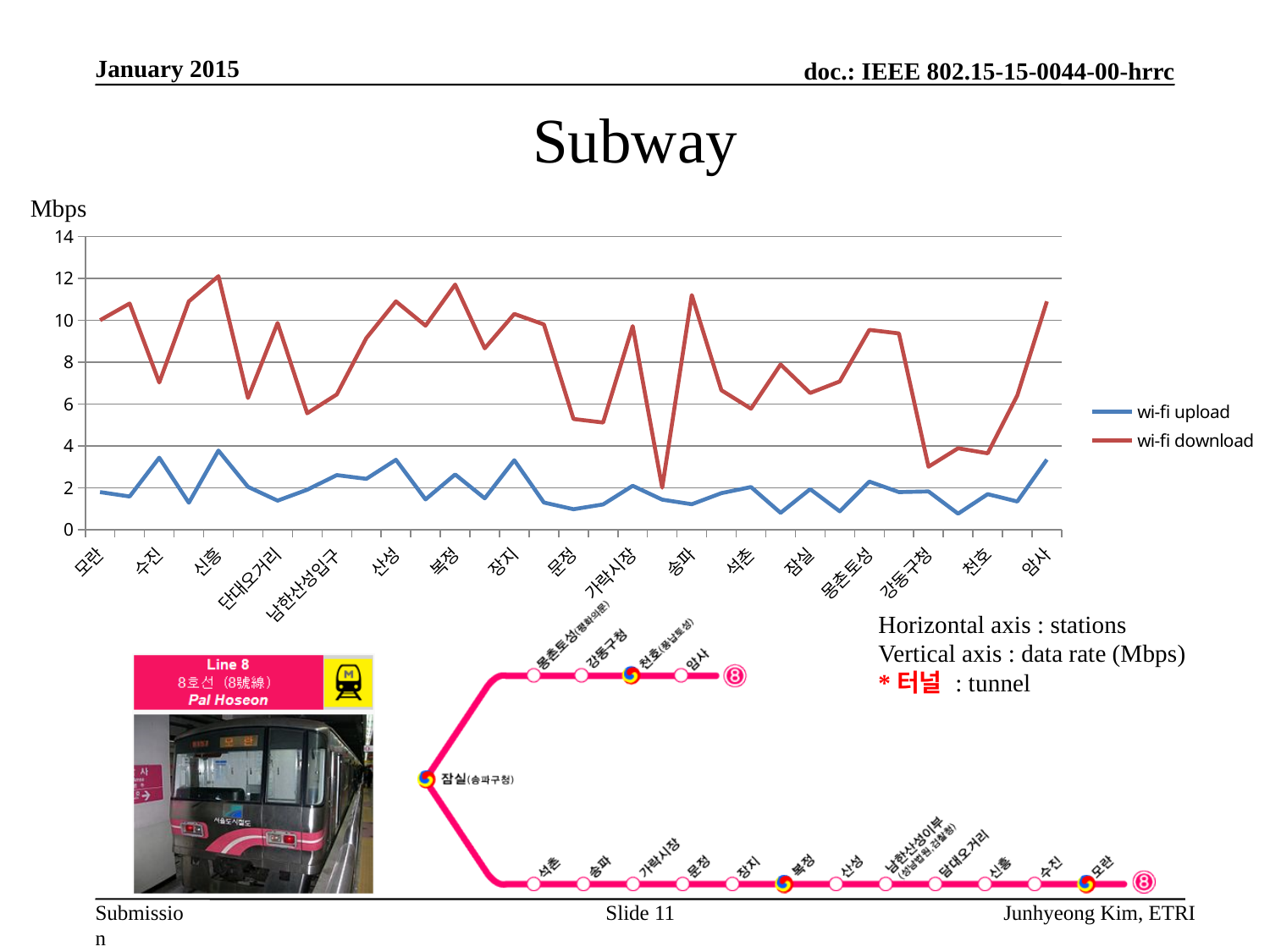
How many series does the chart legend list? 2 Is the wi-fi download value at 강동구청 greater or less than 4? less Is the wi-fi download value at 문정 greater or less than 6? less What are the two series named in the chart legend? wi-fi upload and wi-fi download What type of chart is shown on the slide? line chart Is the wi-fi download value at 복정 greater or less than 10? greater At 신흥, which is larger: wi-fi upload or wi-fi download? wi-fi download Which station has the larger wi-fi download value: 신흥 or 강동구청? 신흥 What unit is shown on the vertical axis of the chart? Mbps